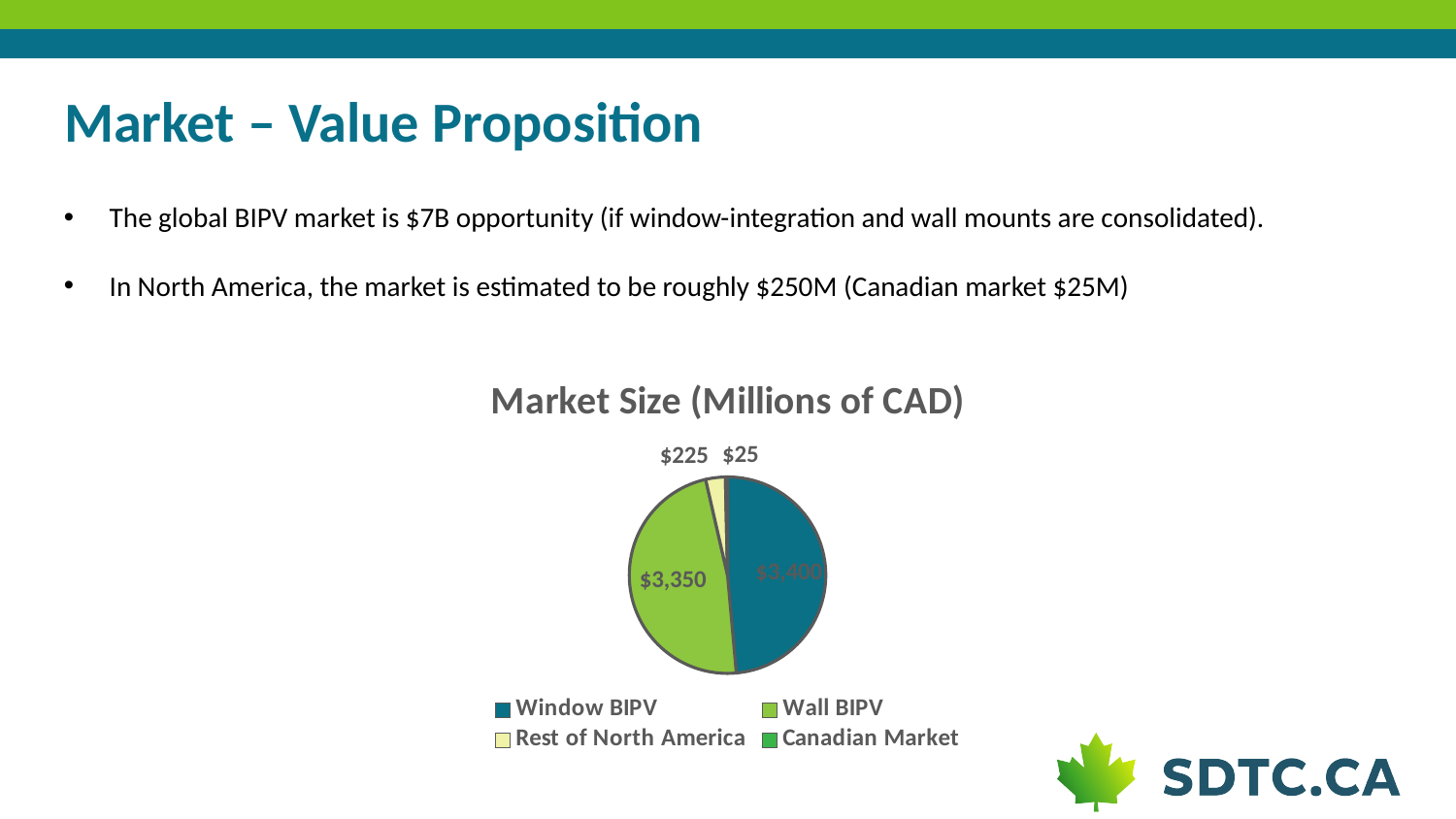
How many slices does the pie chart have? 4 What is the difference between the Rest of North America value and the Canadian Market value? $200 What kind of chart is shown on the slide? pie chart What is the value shown for Canadian Market? $25 Which slice of the pie chart is the smallest? Canadian Market What is the value shown for Wall BIPV? $3,350 What is the title of the chart? Market Size (Millions of CAD) Which is larger, the Wall BIPV slice or the Rest of North America slice? Wall BIPV How many entries does the chart legend list? 4 What is the value shown for Rest of North America? $225 What is the value shown for Window BIPV? $3,400 Which slice of the pie chart is the largest? Window BIPV